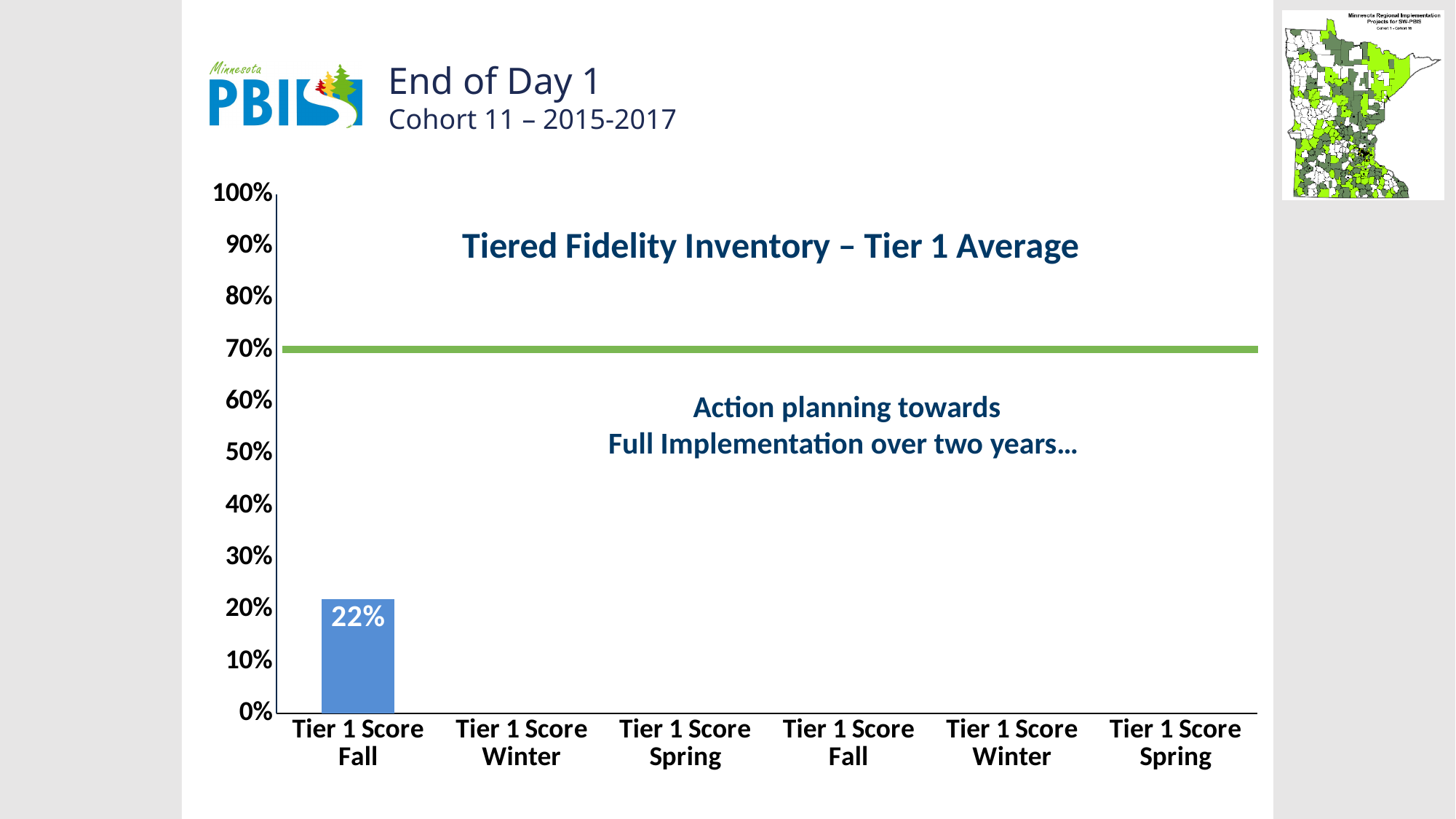
At what percentage is the green horizontal line drawn across the chart? 70% What is the value of the first Tier 1 Score Fall bar? 22% Is the value for the first Tier 1 Score Fall bar greater or less than 30%? less How many categories are listed along the x axis? 6 What is the highest value shown on the y axis? 100% What is the title of the chart? Tiered Fidelity Inventory – Tier 1 Average What kind of chart is shown on the slide? bar chart Is the value for the first Tier 1 Score Fall bar greater or less than 20%? greater Which category is the only one with a plotted bar? Tier 1 Score Fall (first) Is the first Tier 1 Score Fall bar above or below the 70% line? below